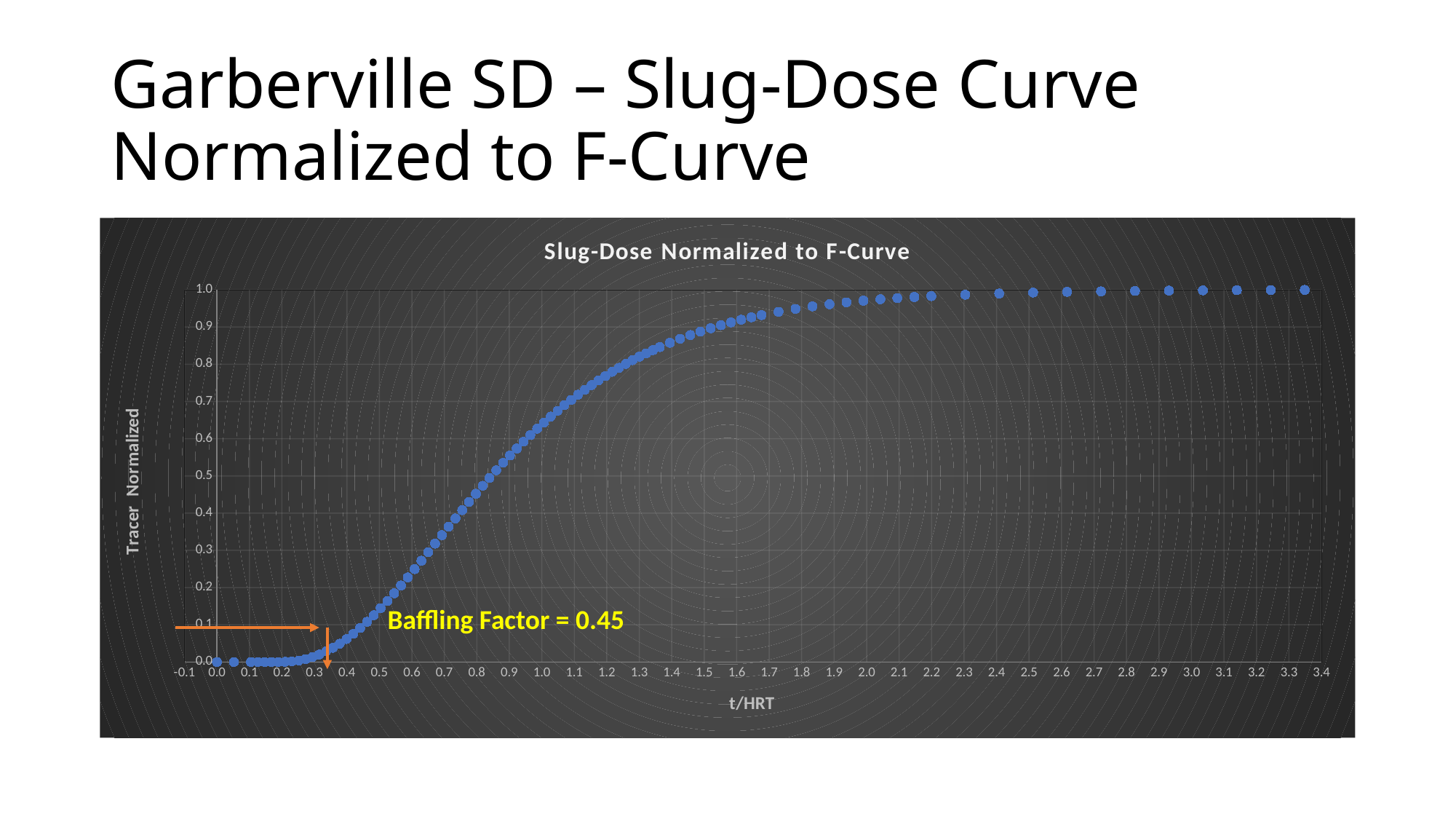
What is the label of the x axis? t/HRT Is the Tracer Normalized value at t/HRT = 1.0 greater or less than 0.5? greater Is the Tracer Normalized value at t/HRT = 0.2 greater or less than 0.1? less What is the highest value shown on the y axis? 1.0 Is the Tracer Normalized value at t/HRT = 1.5 greater or less than 0.8? greater What Baffling Factor is annotated on the chart? 0.45 What kind of chart is shown on the slide? scatter chart Which has the larger Tracer Normalized value, t/HRT = 0.5 or t/HRT = 1.5? t/HRT = 1.5 What is the title of the chart? Slug-Dose Normalized to F-Curve Do the plotted values rise or fall as t/HRT increases? rise